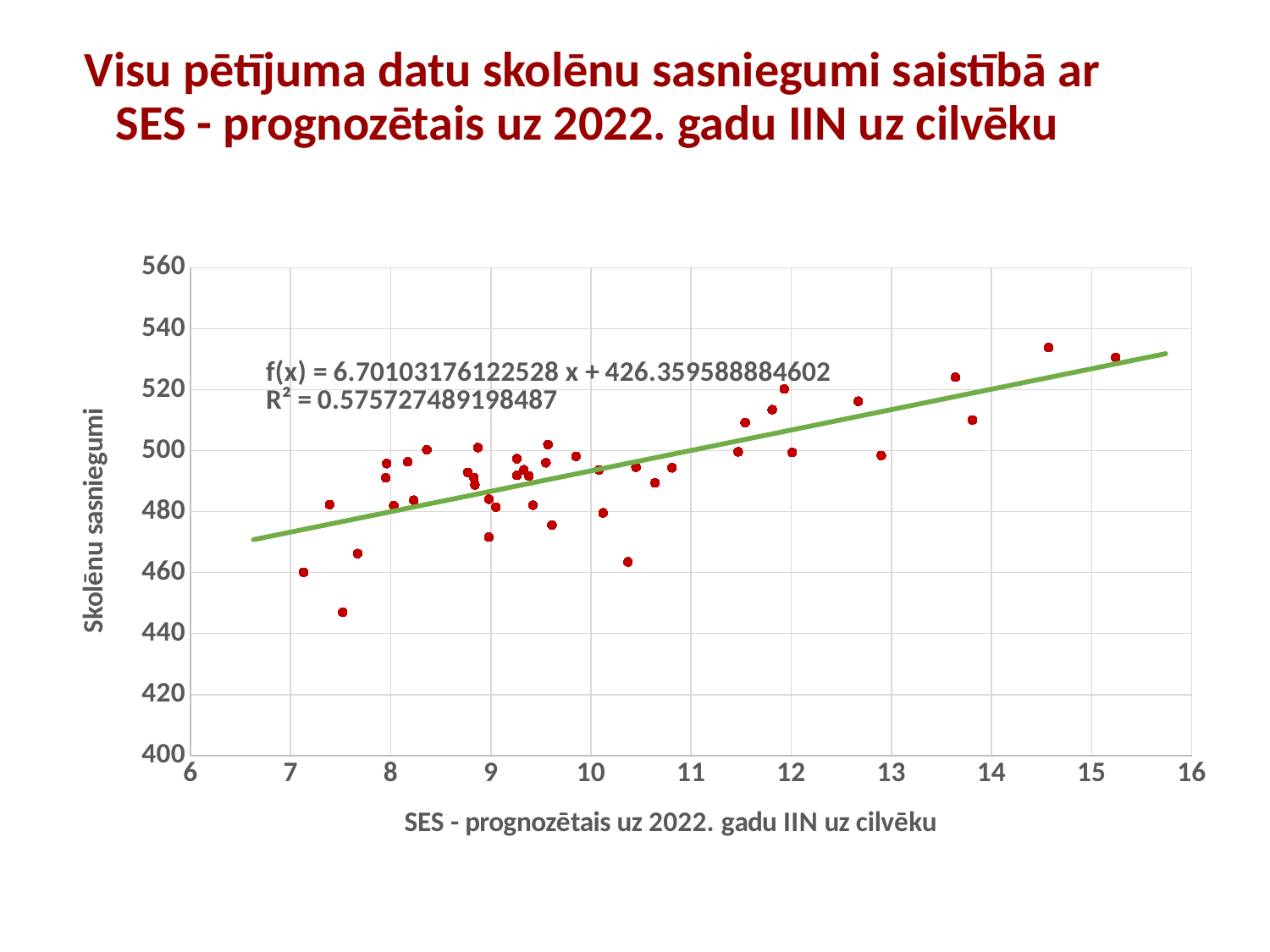
What is the title of the chart's x axis? SES - prognozētais uz 2022. gadu IIN uz cilvēku Is the highest plotted point on the chart greater or less than 520? greater Is the trendline value at x = 7 greater or less than 480? less What is the intercept in the trendline equation f(x) printed on the chart? 426.359588884602 What is the title of the chart's y axis? Skolēnu sasniegumi What kind of chart is shown on the slide? Scatter chart with a trendline What is the R² value printed on the chart? 0.575727489198487 What is the slope of the trendline equation printed on the chart? 6.70103176122528 Is the trendline value at x = 15 greater or less than 520? greater Do the plotted values generally rise or fall as SES increases along the x axis? Rise